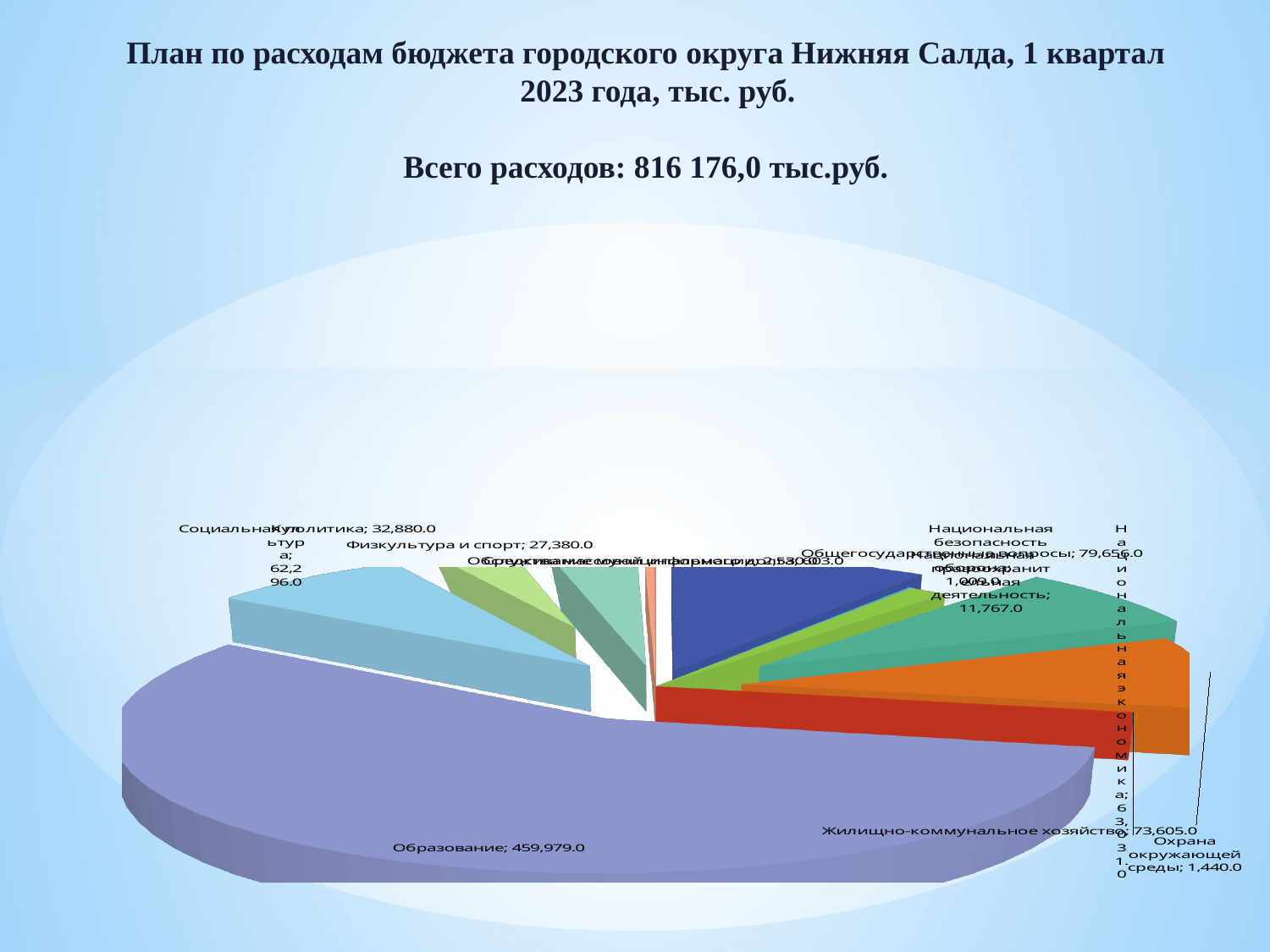
What kind of chart is shown on the slide? pie chart What is the value for Охрана окружающей среды? 1,440.0 Which category has the largest slice of the pie? Образование What is the value for Образование? 459,979.0 What is the value for Социальная политика? 32,880.0 Which is larger, Общегосударственные вопросы or Жилищно-коммунальное хозяйство? Общегосударственные вопросы What is the value for Физкультура и спорт? 27,380.0 What total expenditure is stated on the slide? 816 176,0 тыс.руб. What is the value for Жилищно-коммунальное хозяйство? 73,605.0 What is the value for Общегосударственные вопросы? 79,656.0 What is the difference between Социальная политика and Физкультура и спорт? 5,500.0